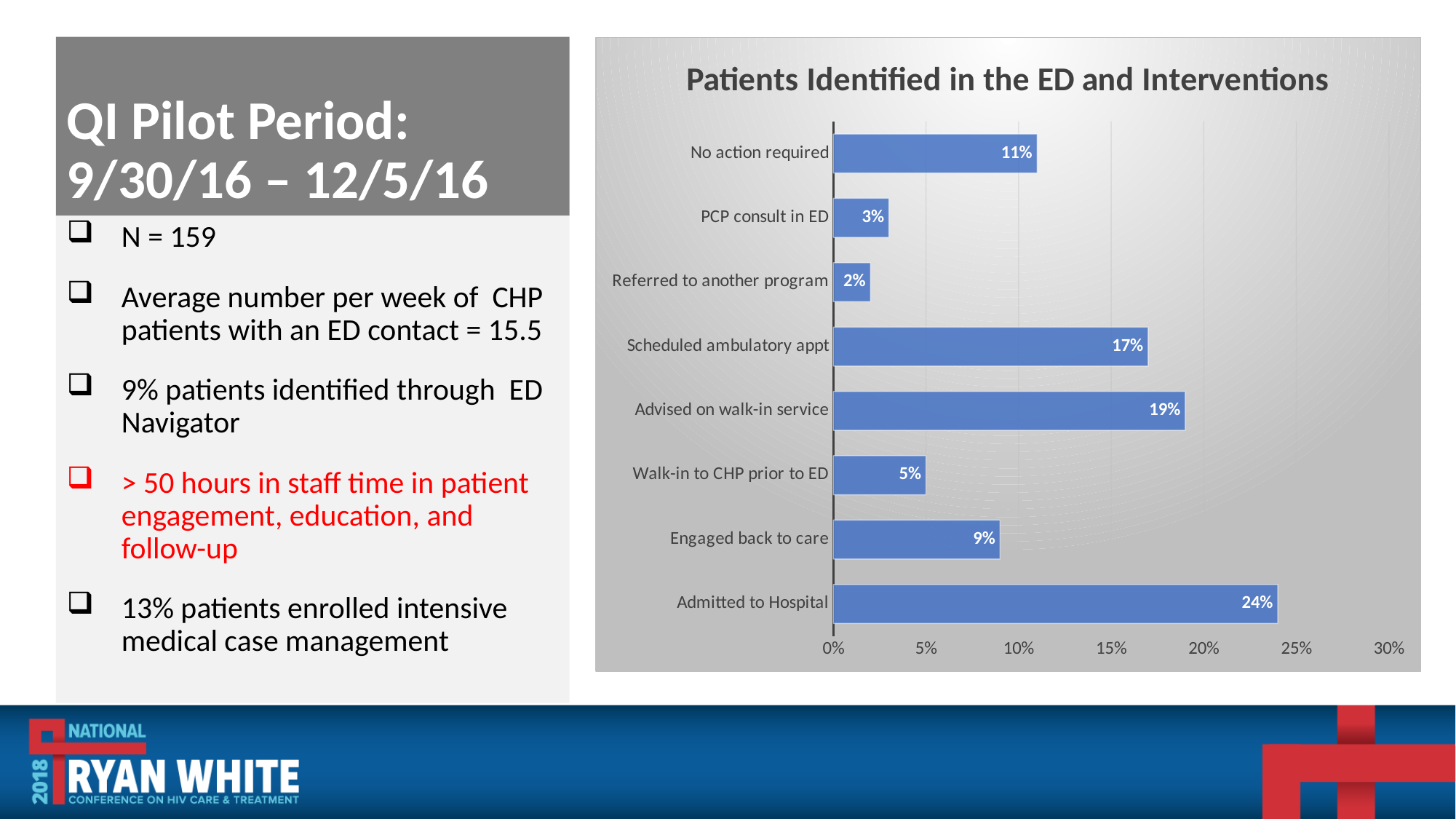
Which category has the lowest value? Referred to another program How many categories are shown in the chart? 8 Which category has the highest value? Admitted to Hospital What is the title of the chart? Patients Identified in the ED and Interventions What is the difference between Advised on walk-in service and Walk-in to CHP prior to ED? 14% What is the value for Admitted to Hospital? 24% What is the value for Referred to another program? 2% What is the value for Scheduled ambulatory appt? 17% What kind of chart is shown? Bar chart Which is larger, No action required or PCP consult in ED? No action required Is the value for Advised on walk-in service greater or less than 15%? greater What is the value for Engaged back to care? 9%